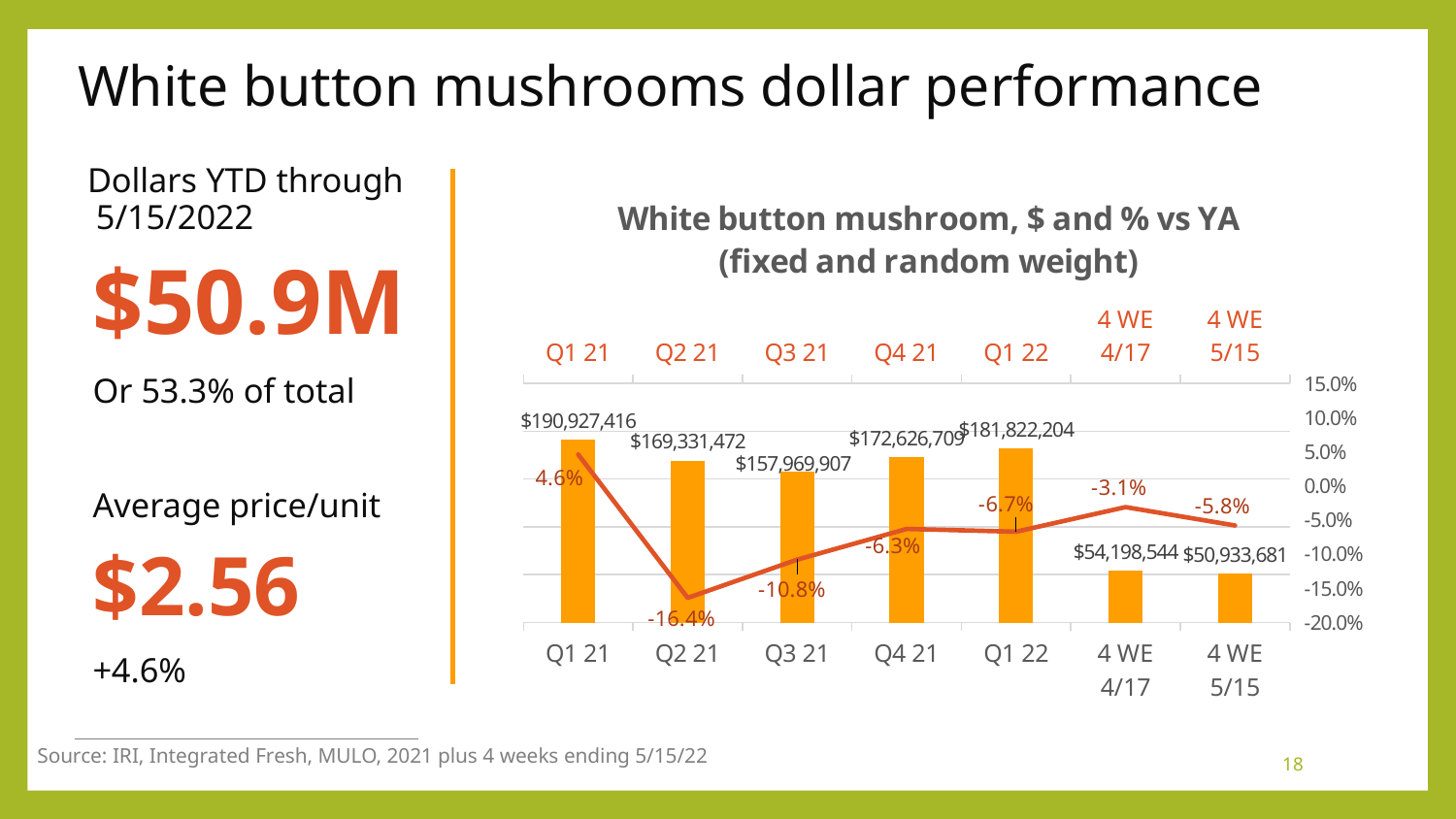
Which period has the lowest % vs YA value? Q2 21 Which is larger, the dollar value for Q2 21 or for Q3 21? Q2 21 What is the dollar value shown for Q1 21? $190,927,416 What is the dollar value shown for the 4 WE 5/15 period? $50,933,681 What kind of chart is this? Combination bar and line chart Do the dollar values rise or fall from Q1 21 to Q3 21? Fall What is the % vs YA value shown for Q1 22? -6.7% How many periods are plotted on the x axis? 7 What is the difference in dollars between Q1 22 and Q4 21? $9,195,495 What is the title of the chart? White button mushroom, $ and % vs YA (fixed and random weight) What is the % vs YA value shown for Q2 21? -16.4% Which period has the highest dollar value? Q1 21